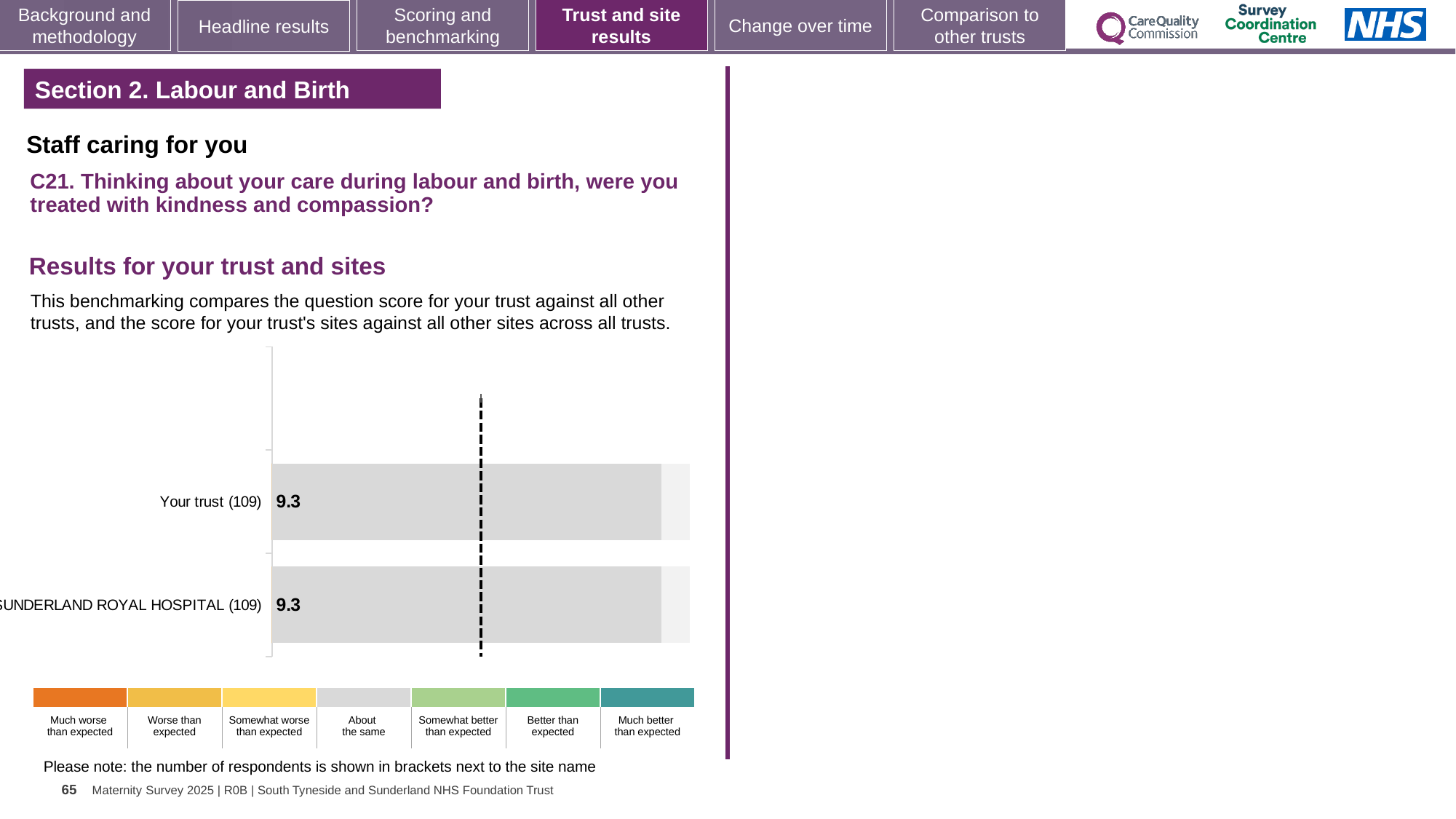
How many benchmark categories are listed in the colour legend below the chart? 7 What kind of chart is shown on the slide? Bar chart What is the score for SUNDERLAND ROYAL HOSPITAL (109)? 9.3 Is the score for Your trust (109) greater or less than 5? greater Which survey question does the chart report results for? C21. Thinking about your care during labour and birth, were you treated with kindness and compassion? How many bars are plotted in the chart? 2 Which benchmark category does the colour of the bar for Your trust (109) correspond to in the legend? About the same How many respondents are shown in brackets for Your trust? 109 What is the score for Your trust (109)? 9.3 How many respondents are shown in brackets for SUNDERLAND ROYAL HOSPITAL? 109 What is the difference between the score for Your trust (109) and the score for SUNDERLAND ROYAL HOSPITAL (109)? 0.0